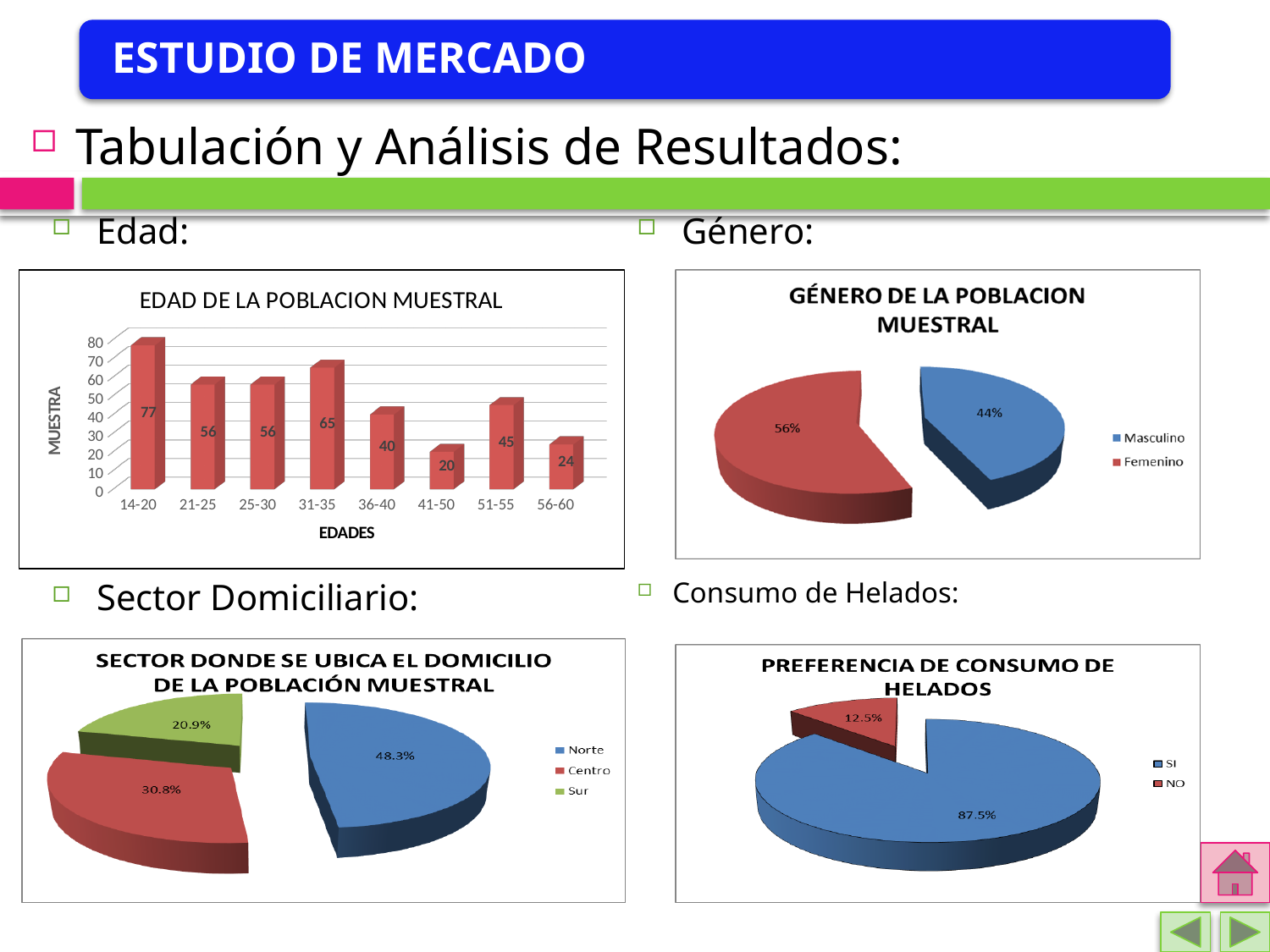
In the 'EDAD DE LA POBLACION MUESTRAL' chart, which age group has the lowest value? 41-50 In the 'EDAD DE LA POBLACION MUESTRAL' chart, how many age groups are shown? 8 How many entries does the legend of the 'SECTOR DONDE SE UBICA EL DOMICILIO DE LA POBLACIÓN MUESTRAL' chart list? 3 In the 'EDAD DE LA POBLACION MUESTRAL' chart, what is the value for the 14-20 age group? 77 In the 'PREFERENCIA DE CONSUMO DE HELADOS' chart, what share is NO? 12.5% In the 'EDAD DE LA POBLACION MUESTRAL' chart, what is the difference between the values for 31-35 and 36-40? 25 In the 'SECTOR DONDE SE UBICA EL DOMICILIO DE LA POBLACIÓN MUESTRAL' chart, which sector has the smallest share? Sur In the 'GÉNERO DE LA POBLACION MUESTRAL' chart, what share is Femenino? 56% In the 'GÉNERO DE LA POBLACION MUESTRAL' chart, which is larger, Masculino or Femenino? Femenino In the 'SECTOR DONDE SE UBICA EL DOMICILIO DE LA POBLACIÓN MUESTRAL' chart, what share is Centro? 30.8% In the 'EDAD DE LA POBLACION MUESTRAL' chart, which age group has the highest value? 14-20 What kind of chart is 'EDAD DE LA POBLACION MUESTRAL'? Bar chart